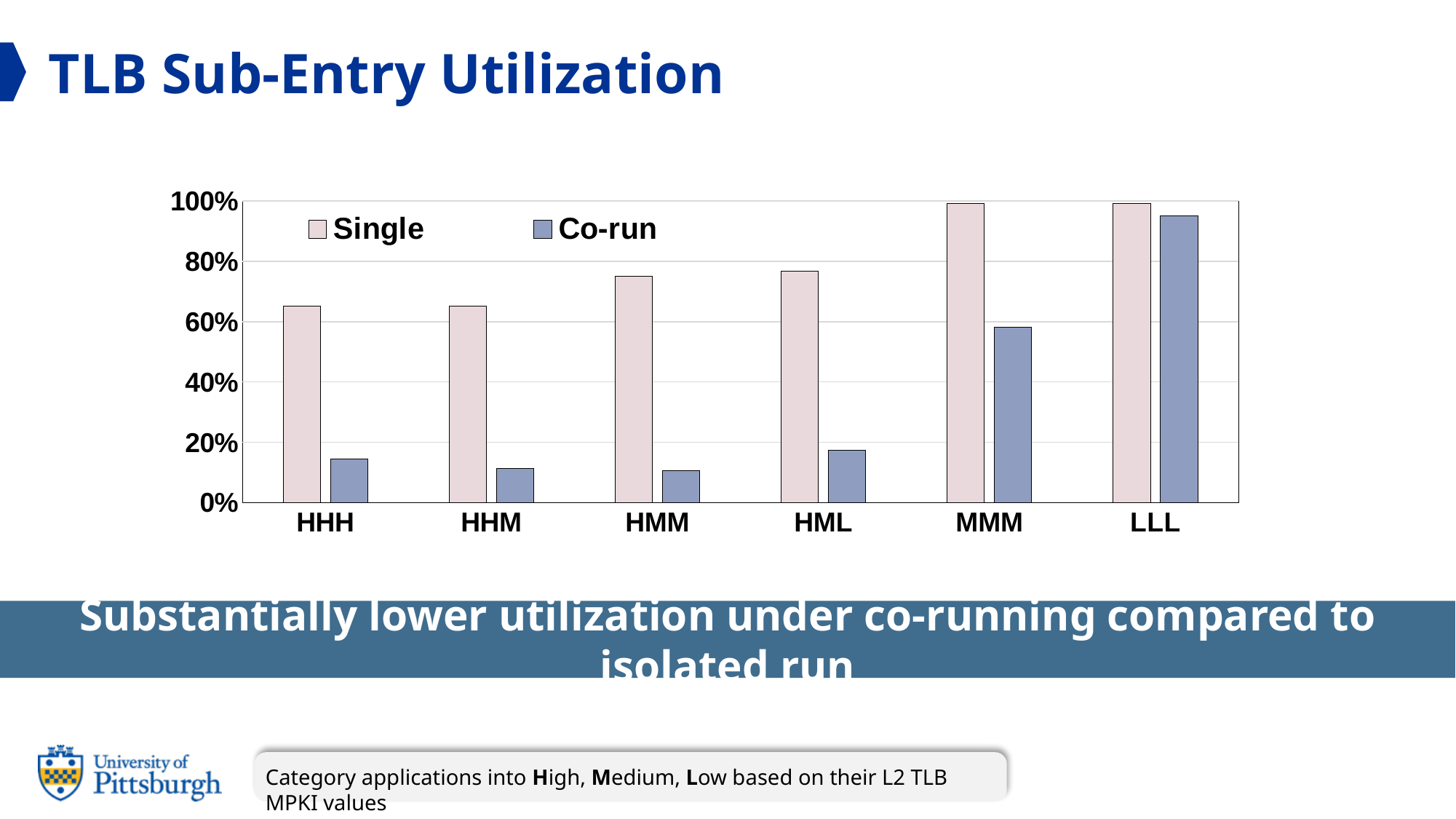
Which category has the highest Co-run value? LLL For HHH, which is larger: the Single value or the Co-run value? Single Is the Single value for HML greater or less than 80%? less Is the Single value for HMM greater or less than 60%? greater Is the Co-run value for MMM greater or less than 40%? greater How many categories are shown on the x axis? 6 What kind of chart is shown on the slide? bar chart What are the two series named in the legend? Single and Co-run How many series does the legend list? 2 Which is larger: the Co-run value for MMM or the Co-run value for HML? MMM